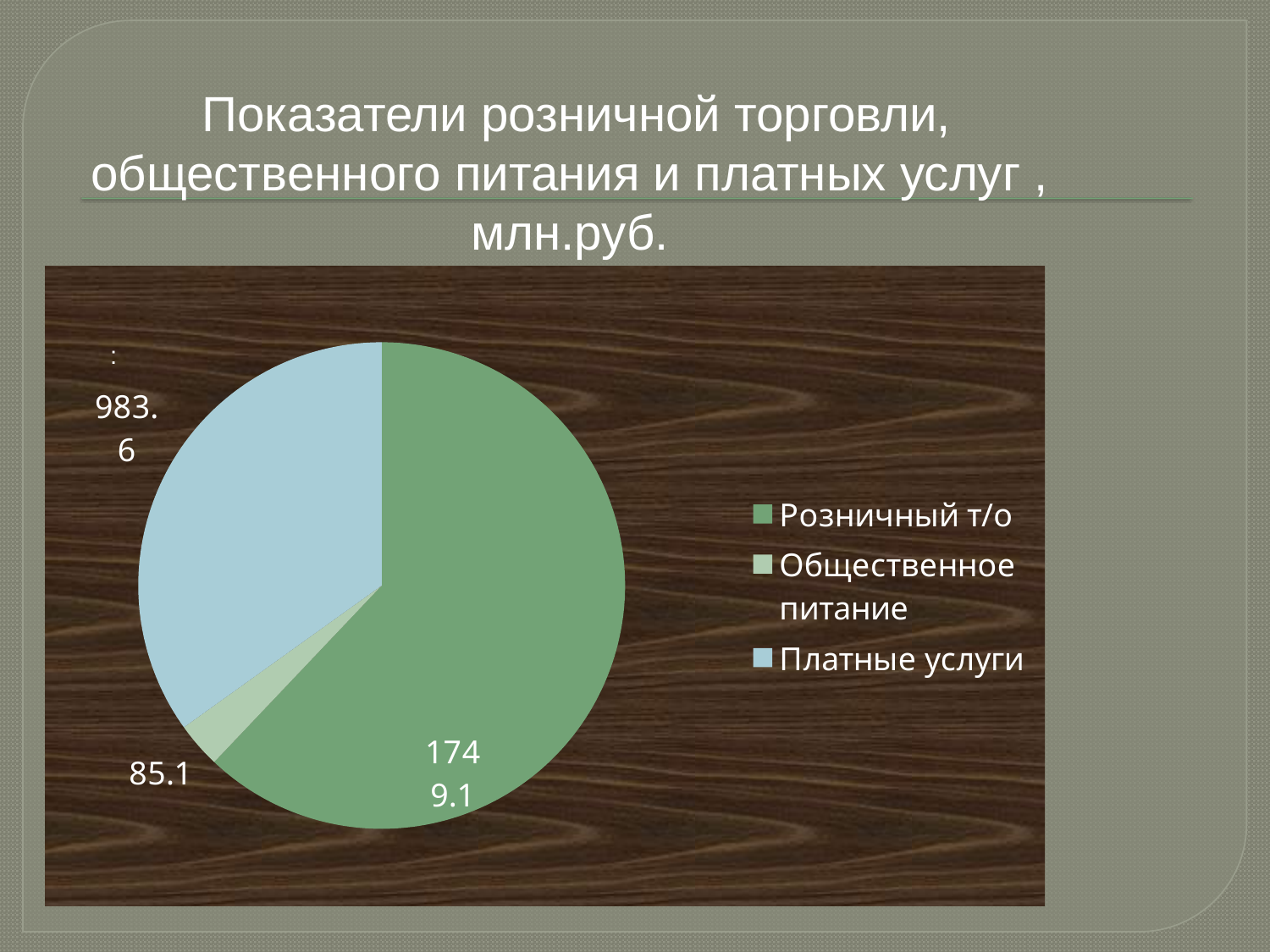
What is the value for Общественное питание? 85.1 What is the value for Розничный т/о? 1749.1 What type of chart is shown on the slide? pie chart What is the value for Платные услуги? 983.6 What is the difference between the values for Розничный т/о and Платные услуги? 765.5 Which is larger, Платные услуги or Общественное питание? Платные услуги How many entries does the legend list? 3 How many categories does the pie chart have? 3 What is the total of all three slices? 2817.8 What colour is the slice for Платные услуги? light blue Which category has the largest slice of the pie? Розничный т/о Which category has the smallest slice of the pie? Общественное питание